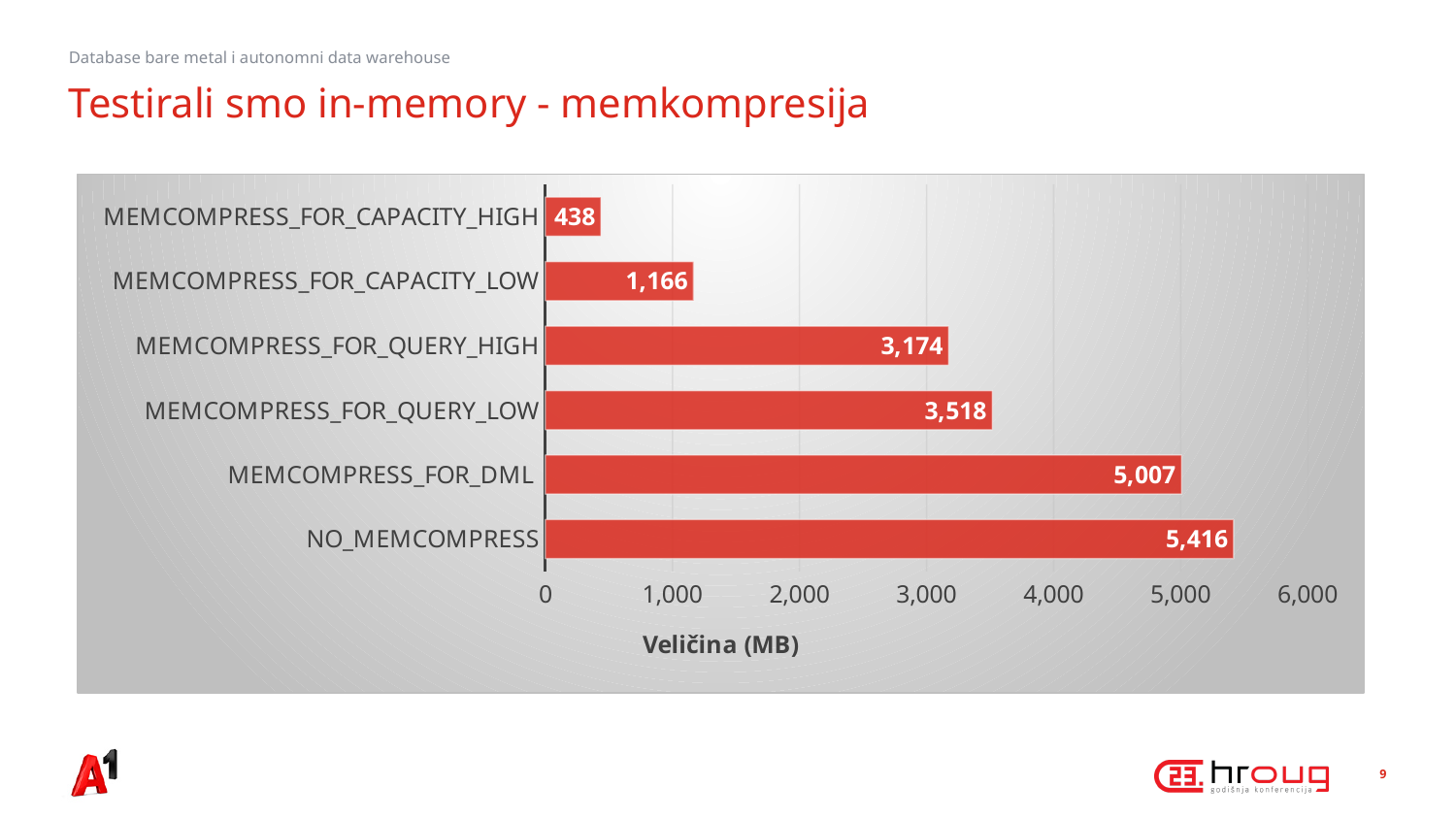
What is the label of the horizontal axis? Veličina (MB) What is the value for NO_MEMCOMPRESS? 5,416 Which category has the lowest value? MEMCOMPRESS_FOR_CAPACITY_HIGH Which category has the highest value? NO_MEMCOMPRESS How many categories are shown in the chart? 6 What is the difference between the values for MEMCOMPRESS_FOR_QUERY_LOW and MEMCOMPRESS_FOR_QUERY_HIGH? 344 What is the value for MEMCOMPRESS_FOR_CAPACITY_HIGH? 438 Which is larger, the value for MEMCOMPRESS_FOR_CAPACITY_LOW or MEMCOMPRESS_FOR_QUERY_HIGH? MEMCOMPRESS_FOR_QUERY_HIGH What is the value for MEMCOMPRESS_FOR_QUERY_LOW? 3,518 What is the value for MEMCOMPRESS_FOR_DML? 5,007 What is the difference between the values for NO_MEMCOMPRESS and MEMCOMPRESS_FOR_CAPACITY_HIGH? 4,978 What kind of chart is shown on the slide? Bar chart